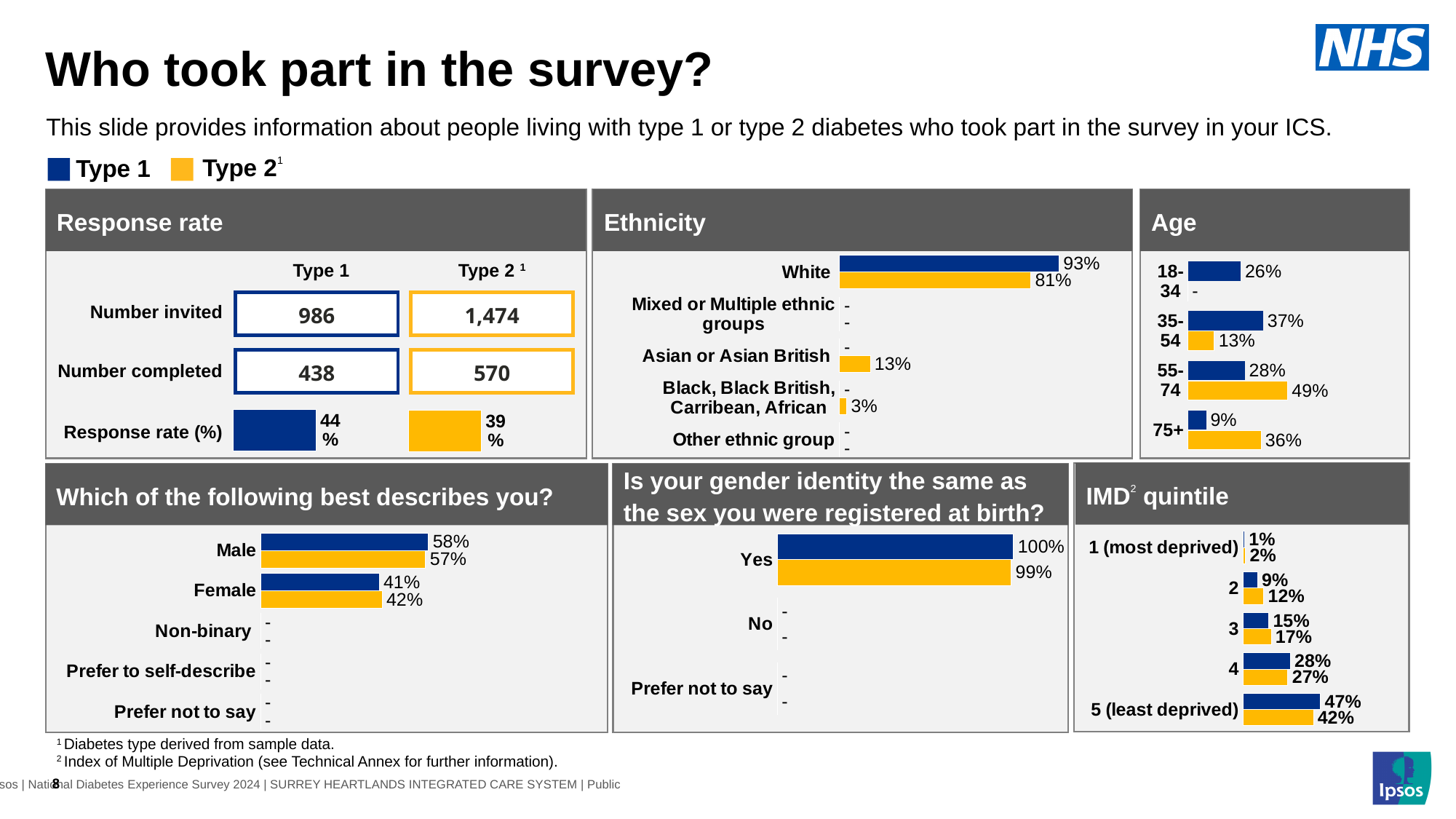
In the 'Which of the following best describes you?' chart, what is the Type 1 value for Male? 58% In the IMD quintile chart, how many quintile categories are shown? 5 In the Ethnicity chart, what is the Type 1 value for White? 93% In the 'Which of the following best describes you?' chart, is the Type 2 value for Female larger or smaller than the Type 1 value for Female? larger In the gender identity chart, what is the Type 2 value for Yes? 99% In the Age chart, which age group has the lowest Type 1 value? 75+ In the IMD quintile chart, what is the difference between the Type 1 and Type 2 values for quintile 2? 3% In the IMD quintile chart, which quintile has the highest Type 1 value? 5 (least deprived) In the Ethnicity chart, what is the Type 2 value for Asian or Asian British? 13% In the Age chart, which age group has the highest Type 2 value? 55-74 What type of chart is the Age chart? bar chart In the Age chart, what is the difference between the Type 1 and Type 2 values for 75+? 27%